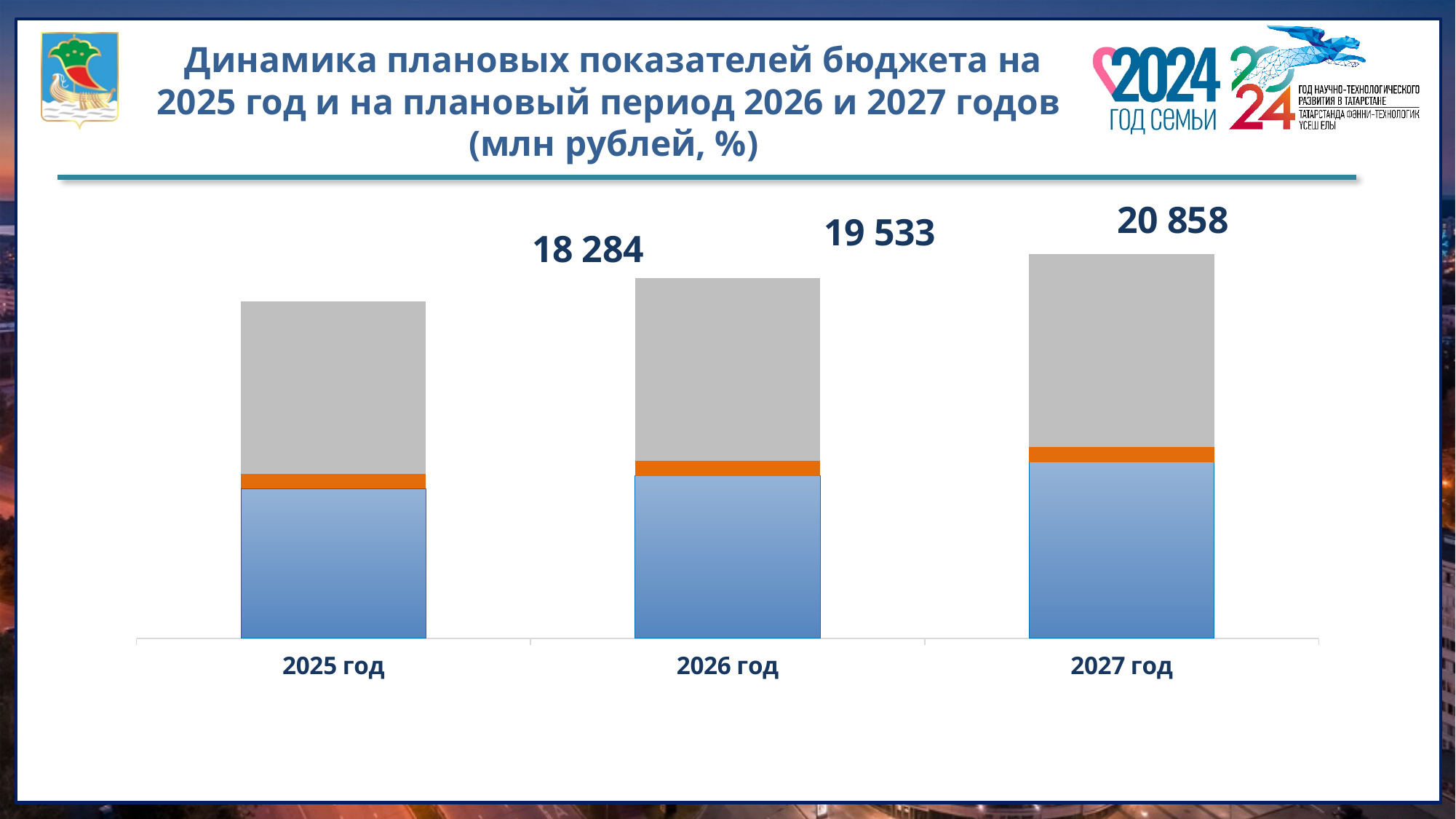
What is the difference between the total for 2026 год and the total for 2025 год? 1 249 What is the total value shown above the bar for 2025 год? 18 284 What is the total value shown above the bar for 2027 год? 20 858 Which is larger, the total for 2026 год or the total for 2027 год? 2027 год What is the total value shown above the bar for 2026 год? 19 533 How many years (categories) are shown on the x axis? 3 What is the difference between the total for 2027 год and the total for 2025 год? 2 574 What kind of chart is shown on the slide? Stacked bar chart Which year has the lowest total value? 2025 год Do the total values rise or fall from 2025 год to 2027 год? Rise How many coloured segments make up each bar? 3 Which year has the highest total value? 2027 год